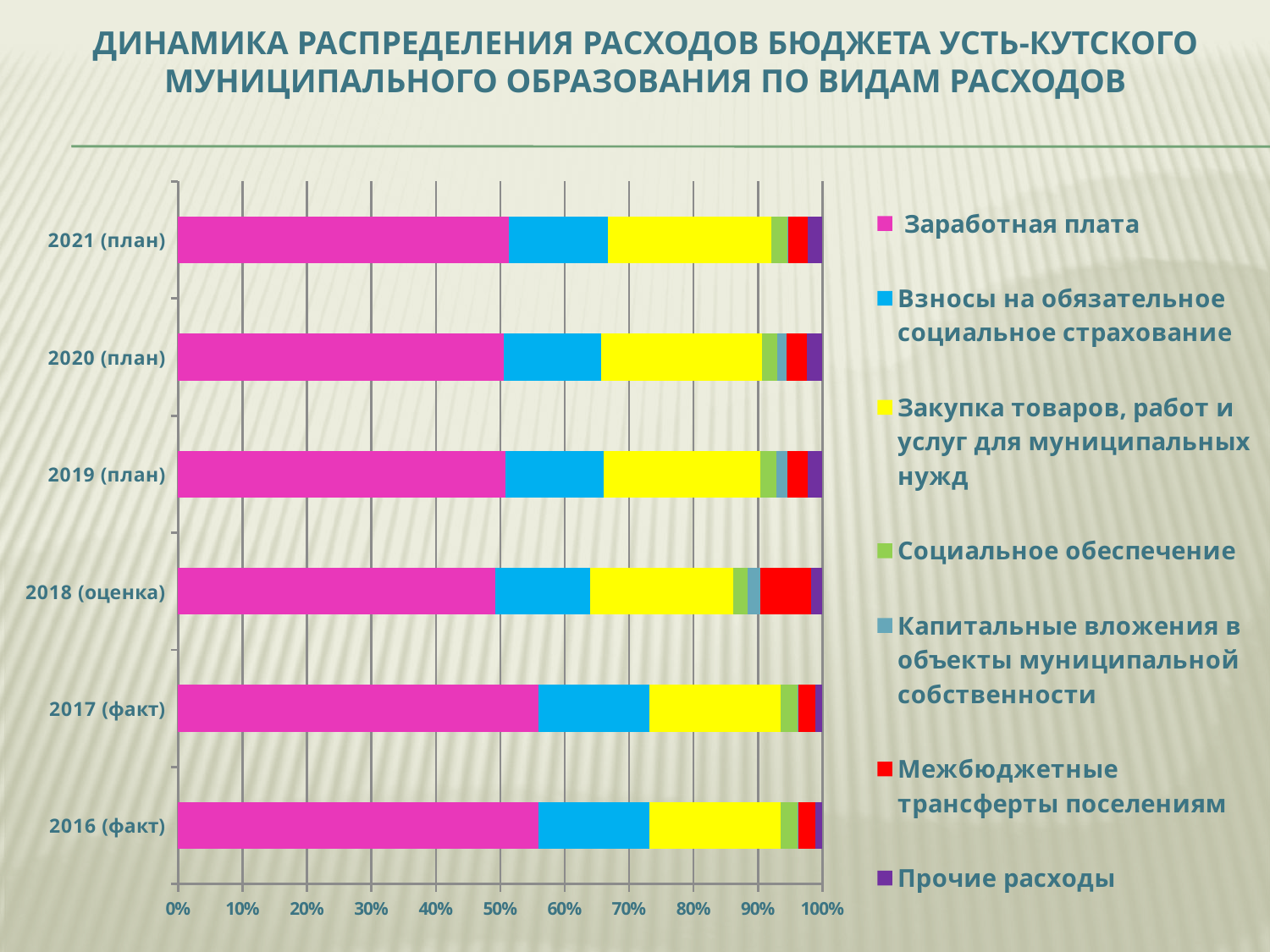
Which category has the largest Межбюджетные трансферты поселениям segment? 2018 (оценка) Is the share of Заработная плата for 2017 (факт) greater or less than 50%? greater Is the share of Заработная плата for 2016 (факт) greater or less than 40%? greater How many series does the legend list? 7 What is the highest value shown on the horizontal axis? 100% Is the share of Заработная плата for 2021 (план) greater or less than 60%? less What kind of chart is shown on the slide? Stacked bar chart Which category is listed at the top of the chart? 2021 (план) Which series is shown in magenta (pink) in the legend? Заработная плата How many categories (years) are plotted on the chart? 6 Which is larger: the Заработная плата share for 2017 (факт) or for 2018 (оценка)? 2017 (факт)